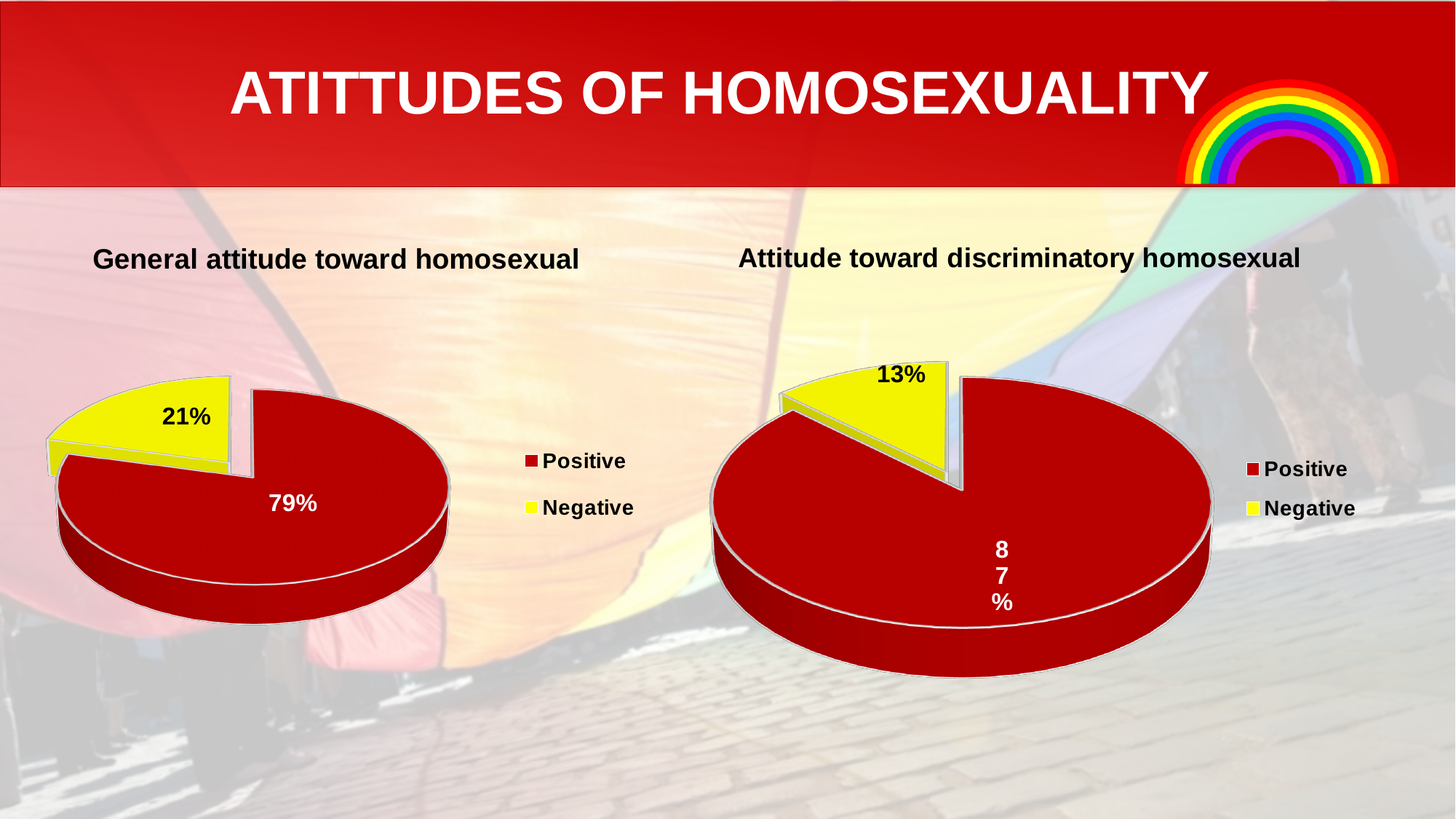
In the 'General attitude toward homosexual' chart, what is the difference between the Positive and Negative percentages? 58% In the 'General attitude toward homosexual' chart, what percentage is Positive? 79% In the 'General attitude toward homosexual' chart, which category has the largest slice? Positive In the 'Attitude toward discriminatory homosexual' chart, what is the difference between the Positive and Negative percentages? 74% Which chart has the larger Negative share, 'General attitude toward homosexual' or 'Attitude toward discriminatory homosexual'? General attitude toward homosexual How many categories does the 'Attitude toward discriminatory homosexual' chart show? 2 In the 'General attitude toward homosexual' chart, what percentage is Negative? 21% In the 'Attitude toward discriminatory homosexual' chart, what percentage is Negative? 13% What type of chart is used for 'General attitude toward homosexual'? Pie chart In the 'Attitude toward discriminatory homosexual' chart, what percentage is Positive? 87% In the 'Attitude toward discriminatory homosexual' chart, which category has the smallest slice? Negative In the 'General attitude toward homosexual' chart, what colour represents Negative? Yellow